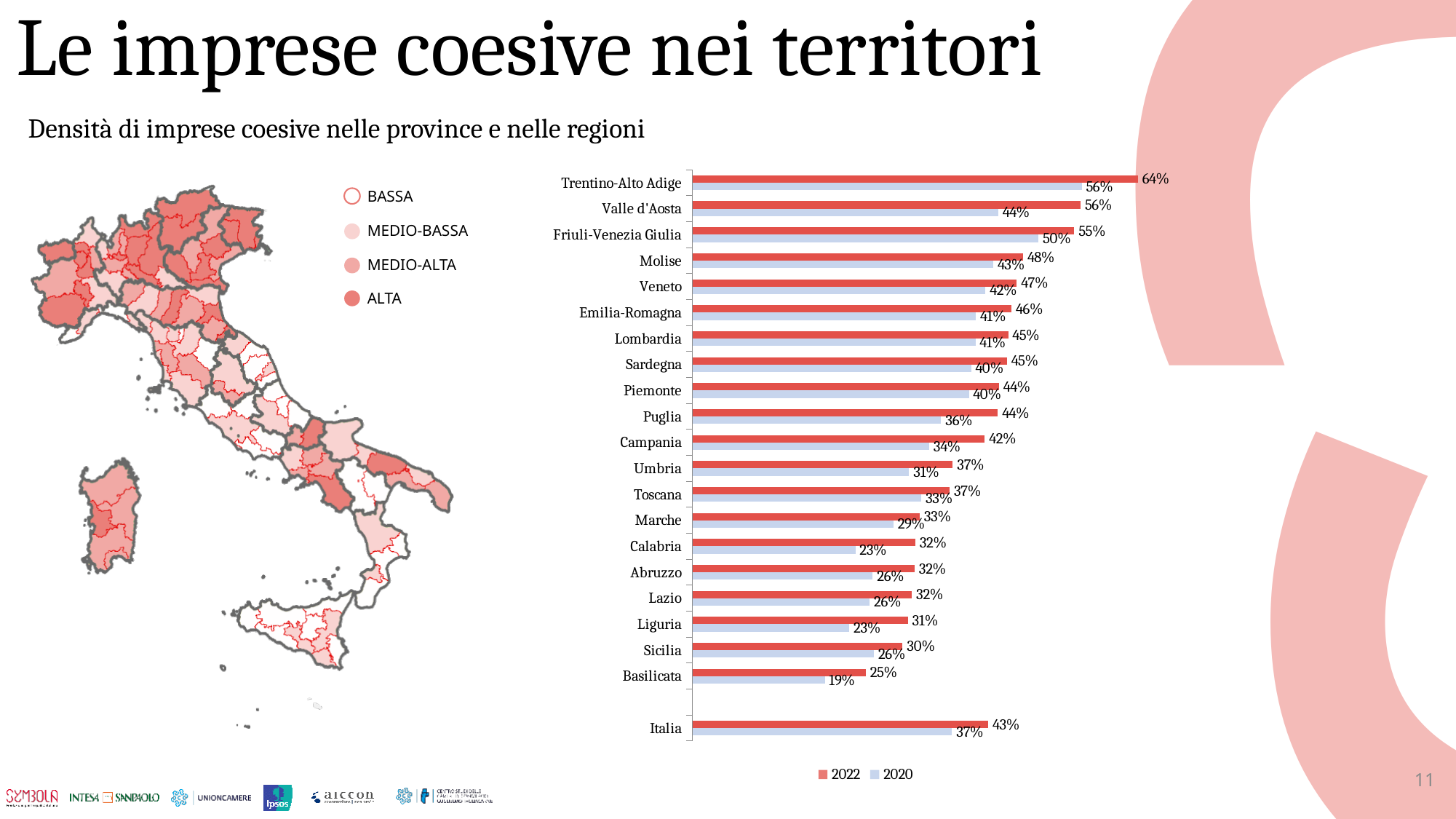
How many categories (regions plus Italia) are shown in the bar chart? 21 How many series does the bar chart's legend list? 2 In the bar chart, which is larger: the 2020 value for Friuli-Venezia Giulia or the 2020 value for Molise? Friuli-Venezia Giulia In the bar chart, what is the difference between the 2022 and 2020 values for Calabria? 9% In the bar chart, what is the 2020 value for Valle d'Aosta? 44% In the bar chart, which region has the lowest 2020 value? Basilicata What kind of chart is shown on the right of the slide? Bar chart In the bar chart, which region has the highest 2022 value? Trentino-Alto Adige In the bar chart, what is the difference between the 2022 values for Puglia and Campania? 2% In the bar chart, what is the 2022 value for Trentino-Alto Adige? 64% In the bar chart, what is the 2022 value for Italia? 43% Which two years are listed in the bar chart's legend? 2022 and 2020